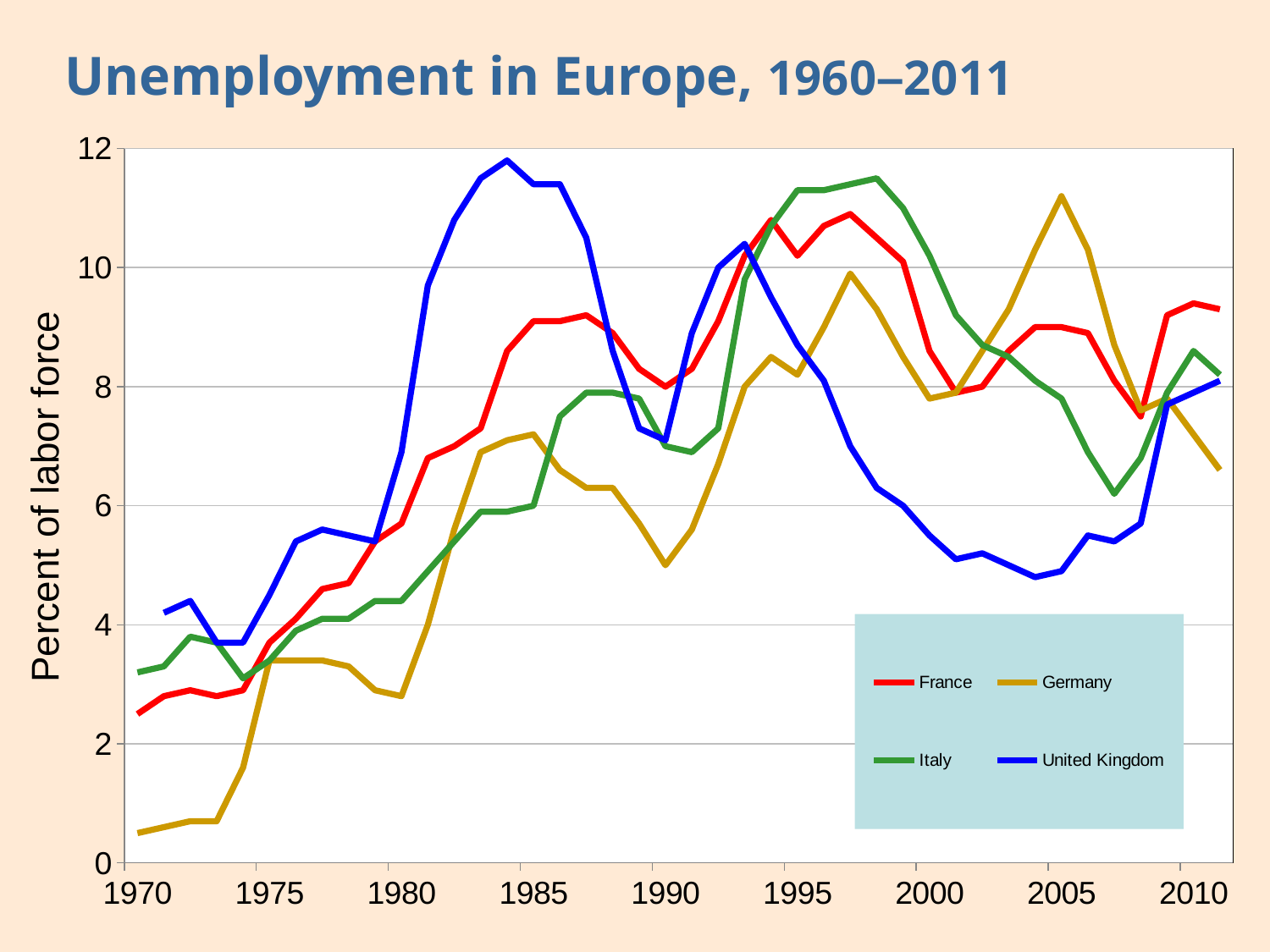
In 2005, which is larger, the value for Germany or the value for the United Kingdom? Germany Is the value for the United Kingdom in 1985 greater or less than 10? greater Is the value for the United Kingdom in 2005 greater or less than 6? less Does the value for Germany rise or fall between 1970 and 1985? rise What is the label on the vertical axis? Percent of labor force Is the value for France in 1985 greater or less than 8? greater In 1985, which is larger, the value for the United Kingdom or the value for Germany? United Kingdom What kind of chart is shown on the slide? line chart How many series does the legend list? 4 Which countries are listed in the legend? France, Germany, Italy, United Kingdom